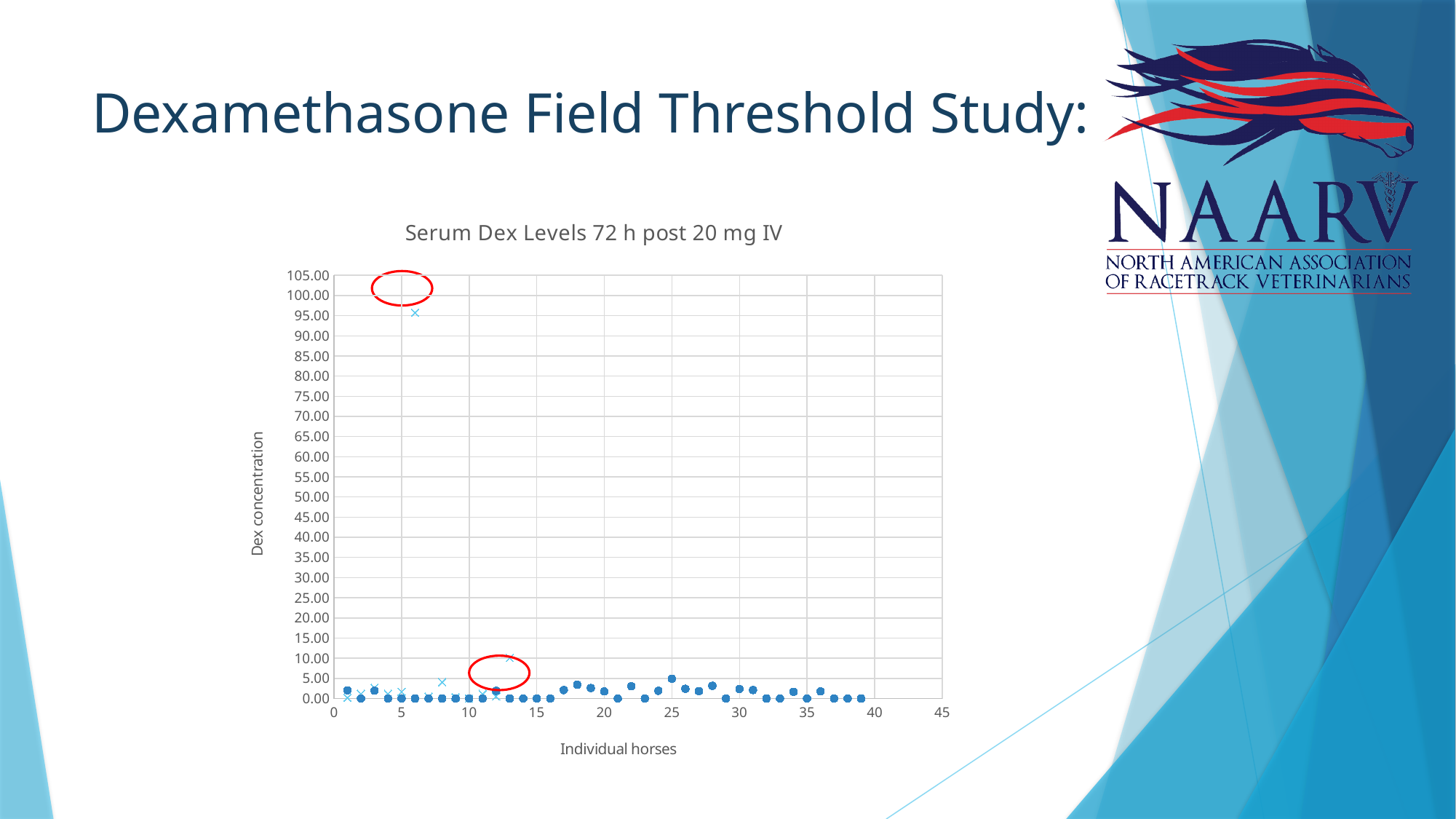
Is the highest plotted point on the chart greater or less than 100.00? less Is the dot value plotted at horse 18 greater or less than 10.00? less What is the label on the vertical axis of the chart? Dex concentration Is the x-marker value plotted near horse 13 greater or less than 5.00? greater What kind of chart is shown on the slide? scatter chart What is the title of the chart? Serum Dex Levels 72 h post 20 mg IV Which is larger: the x-marker value near horse 6 or the x-marker value near horse 13? the x-marker near horse 6 Which is larger: the dot value at horse 25 or the dot value at horse 38? the dot at horse 25